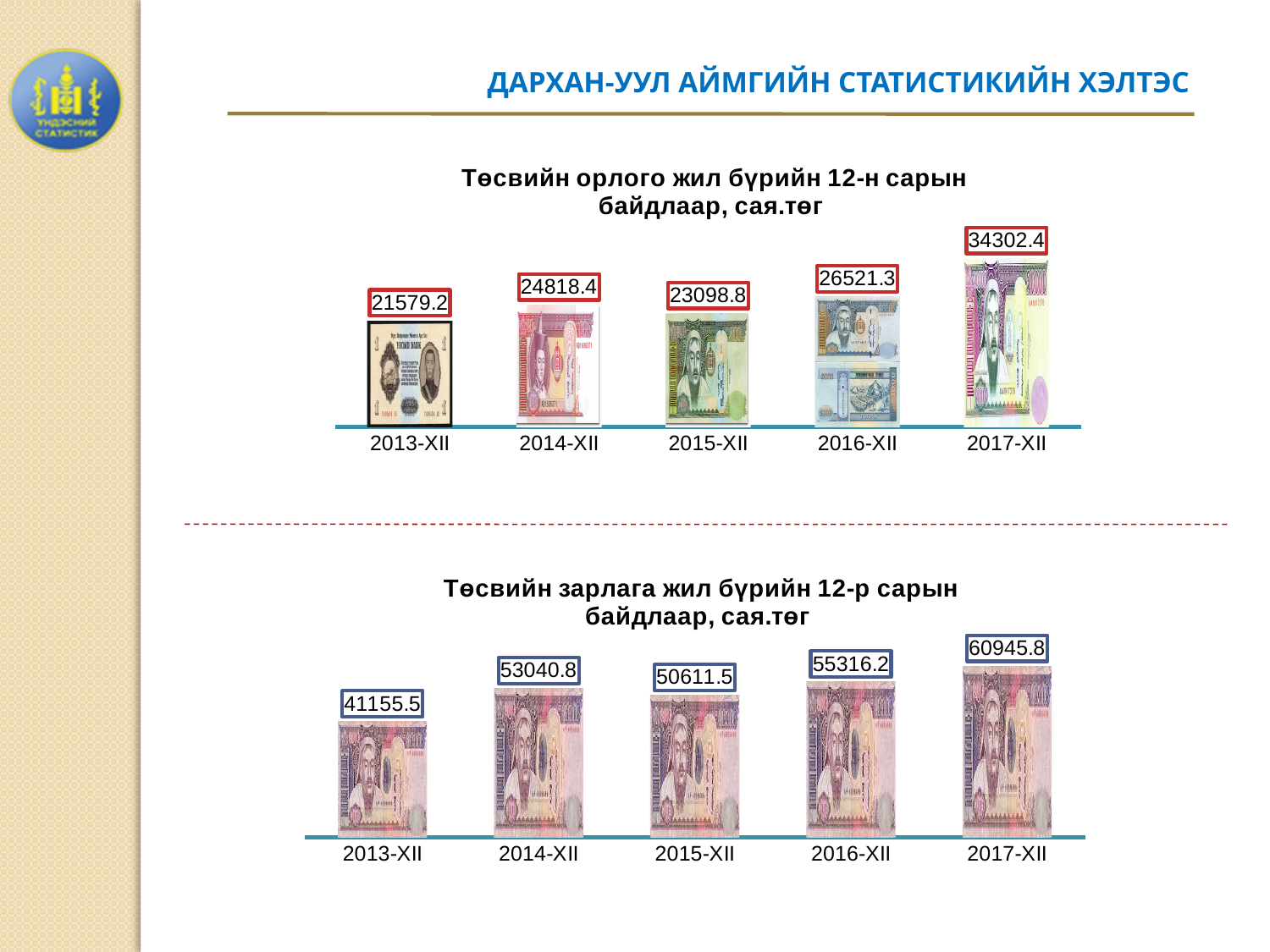
In the top chart (Төсвийн орлого), which is larger, the value for 2014-XII or 2015-XII? 2014-XII In the top chart (Төсвийн орлого), what is the value for 2016-XII? 26521.3 In the bottom chart (Төсвийн зарлага), what is the value for 2017-XII? 60945.8 In the bottom chart (Төсвийн зарлага), which period has the lowest value? 2013-XII In the top chart (Төсвийн орлого), what is the value for 2013-XII? 21579.2 In the top chart (Төсвийн орлого), what is the difference between the 2017-XII and 2013-XII values? 12723.2 In the top chart (Төсвийн орлого), which period has the highest value? 2017-XII How many periods are shown on the x axis of the bottom chart (Төсвийн зарлага)? 5 In the bottom chart (Төсвийн зарлага), what is the value for 2015-XII? 50611.5 What kind of chart is the top chart (Төсвийн орлого)? Bar chart In the top chart (Төсвийн орлого), which period has the lowest value? 2013-XII In the bottom chart (Төсвийн зарлага), what is the difference between the 2014-XII and 2015-XII values? 2429.3